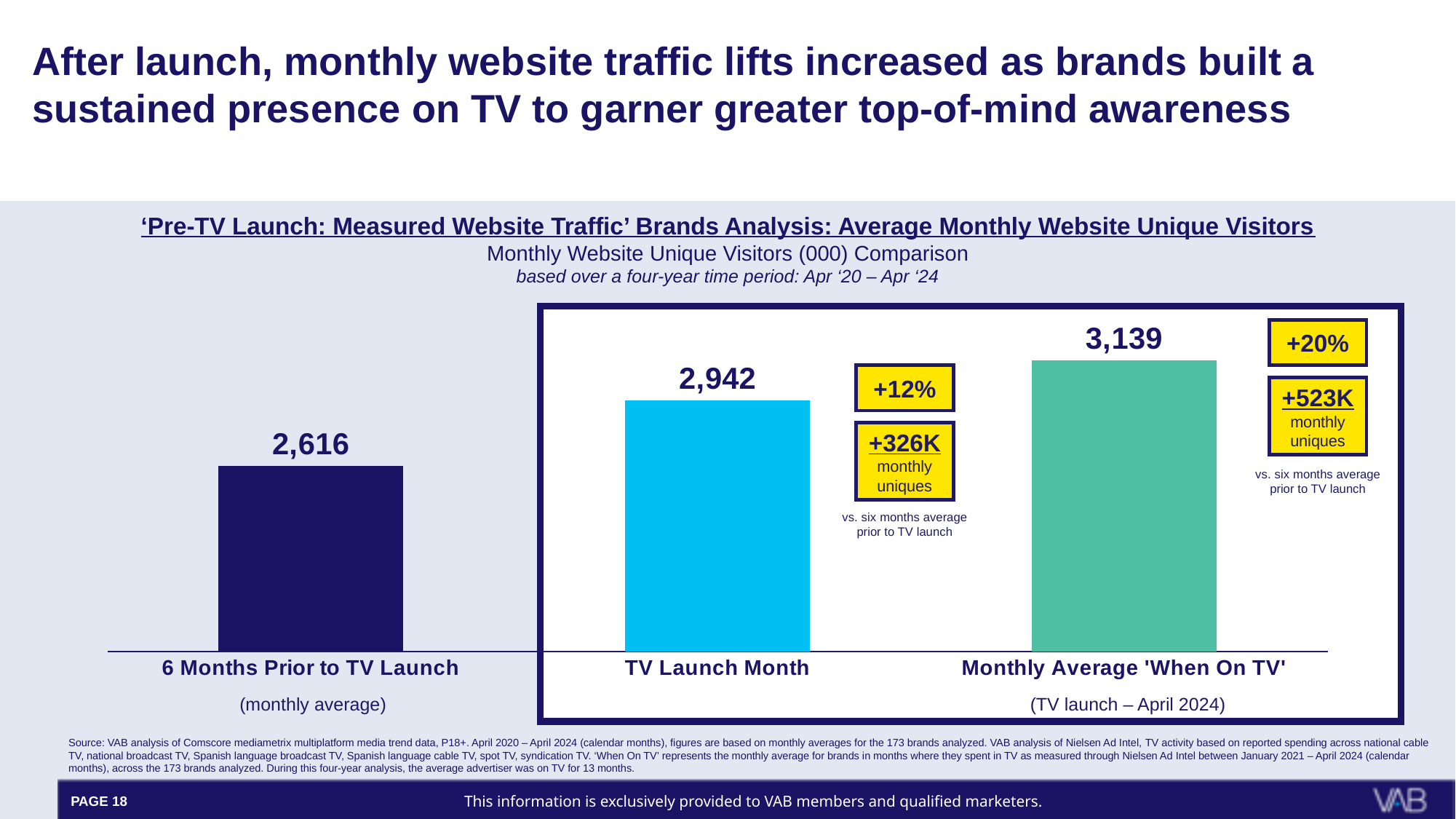
What is the value for '6 Months Prior to TV Launch'? 2,616 Which category has the highest value? Monthly Average 'When On TV' What percentage lift is shown for 'Monthly Average 'When On TV'' versus the six months average prior to TV launch? +20% What is the value for 'TV Launch Month'? 2,942 Do the values rise or fall from left to right across the categories? Rise What is the difference between the 'TV Launch Month' value and the '6 Months Prior to TV Launch' value? 326 How many categories are shown in the chart? 3 What is the difference between the 'Monthly Average 'When On TV'' value and the '6 Months Prior to TV Launch' value? 523 Which category has the lowest value? 6 Months Prior to TV Launch Which is larger, the value for 'TV Launch Month' or the value for 'Monthly Average 'When On TV''? Monthly Average 'When On TV' What kind of chart is shown on the slide? Bar chart What is the value for 'Monthly Average 'When On TV''? 3,139